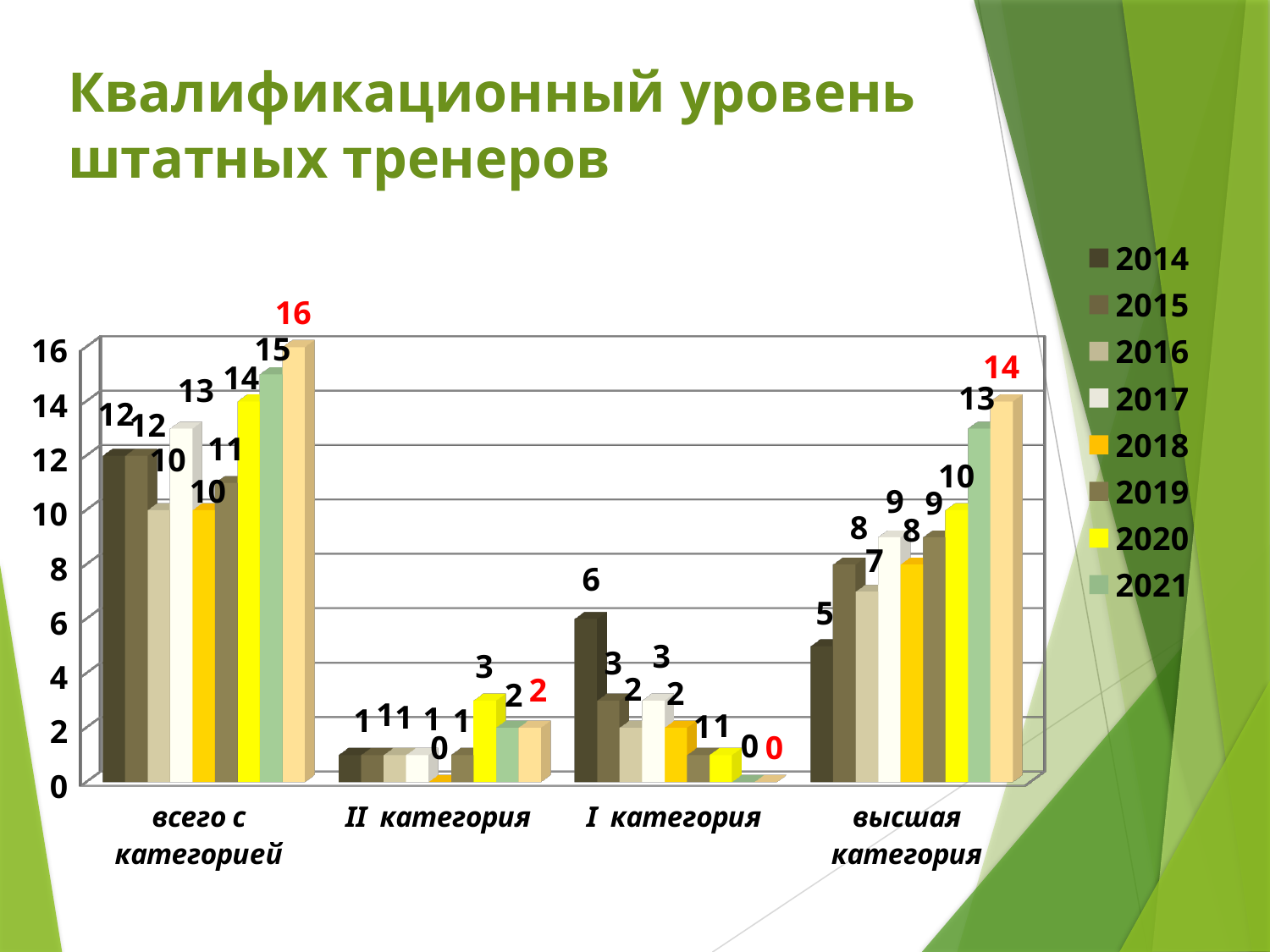
How many categories are shown along the x axis of the chart? 4 What is the value for 2014 in the category 'всего с категорией'? 12 What is the highest labeled value in the category 'высшая категория'? 14 In the category 'I категория', do the values generally rise or fall from 2014 to 2021? fall How many series does the legend list? 8 What kind of chart is shown on the slide? bar chart What is the value for 2018 in the category 'II категория'? 0 What is the title of the chart on the slide? Квалификационный уровень штатных тренеров For 2020, which category has the larger value: 'II категория' or 'I категория'? II категория What is the value for 2014 in the category 'I категория'? 6 What is the value for 2021 in the category 'высшая категория'? 13 What is the difference between the 2021 and 2014 values in the category 'всего с категорией'? 3